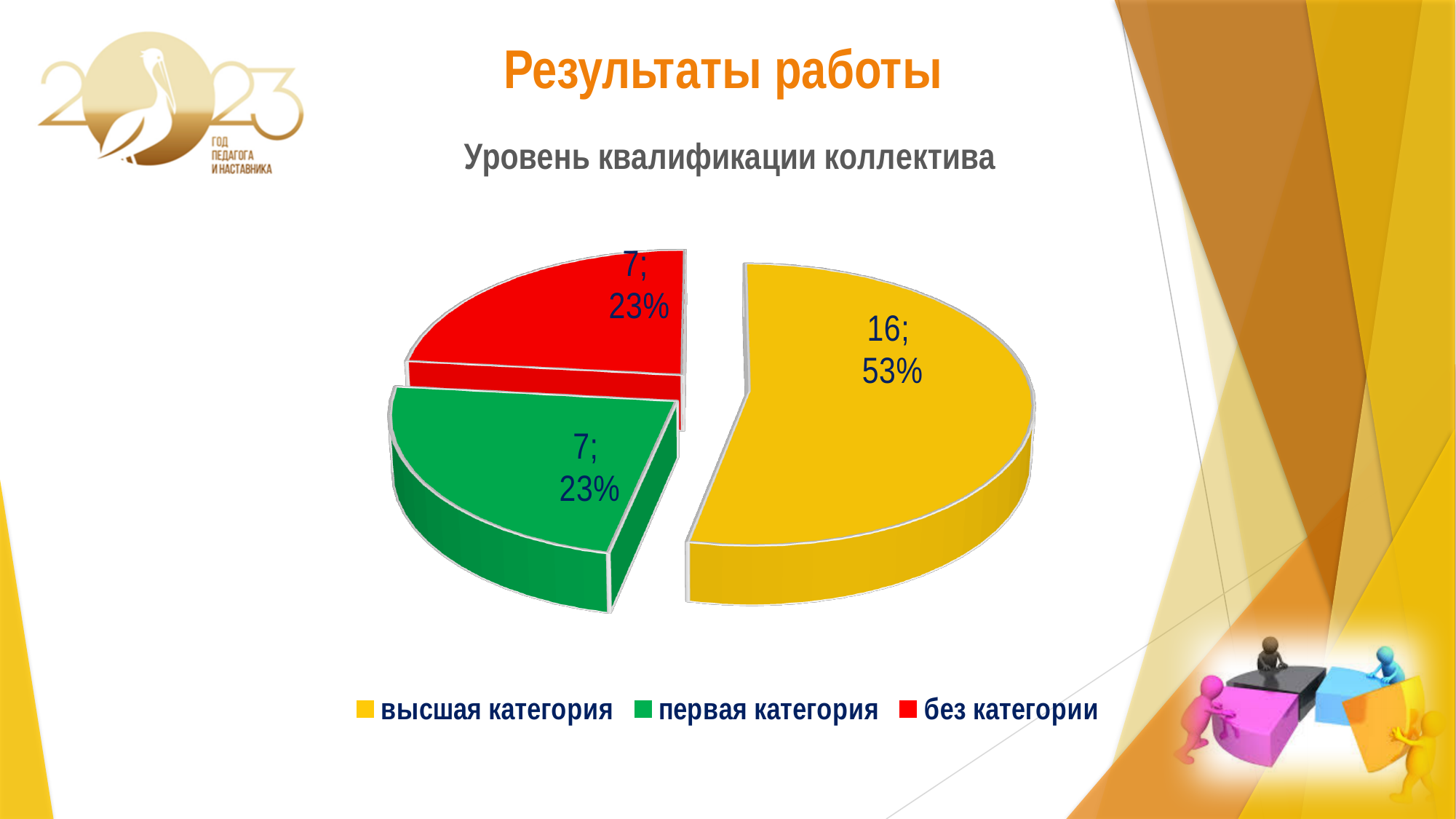
What is the difference between the values for высшая категория and первая категория? 9 What is the value for первая категория? 7 How many categories does the legend list? 3 How many slices does the pie chart have? 3 What share of the pie does без категории take? 23% What share of the pie does высшая категория take? 53% What is the value for без категории? 7 What is the value for высшая категория? 16 Which colour represents первая категория in the chart? green Which category has the largest slice? высшая категория What is the title of the chart? Уровень квалификации коллектива What kind of chart is shown on the slide? pie chart